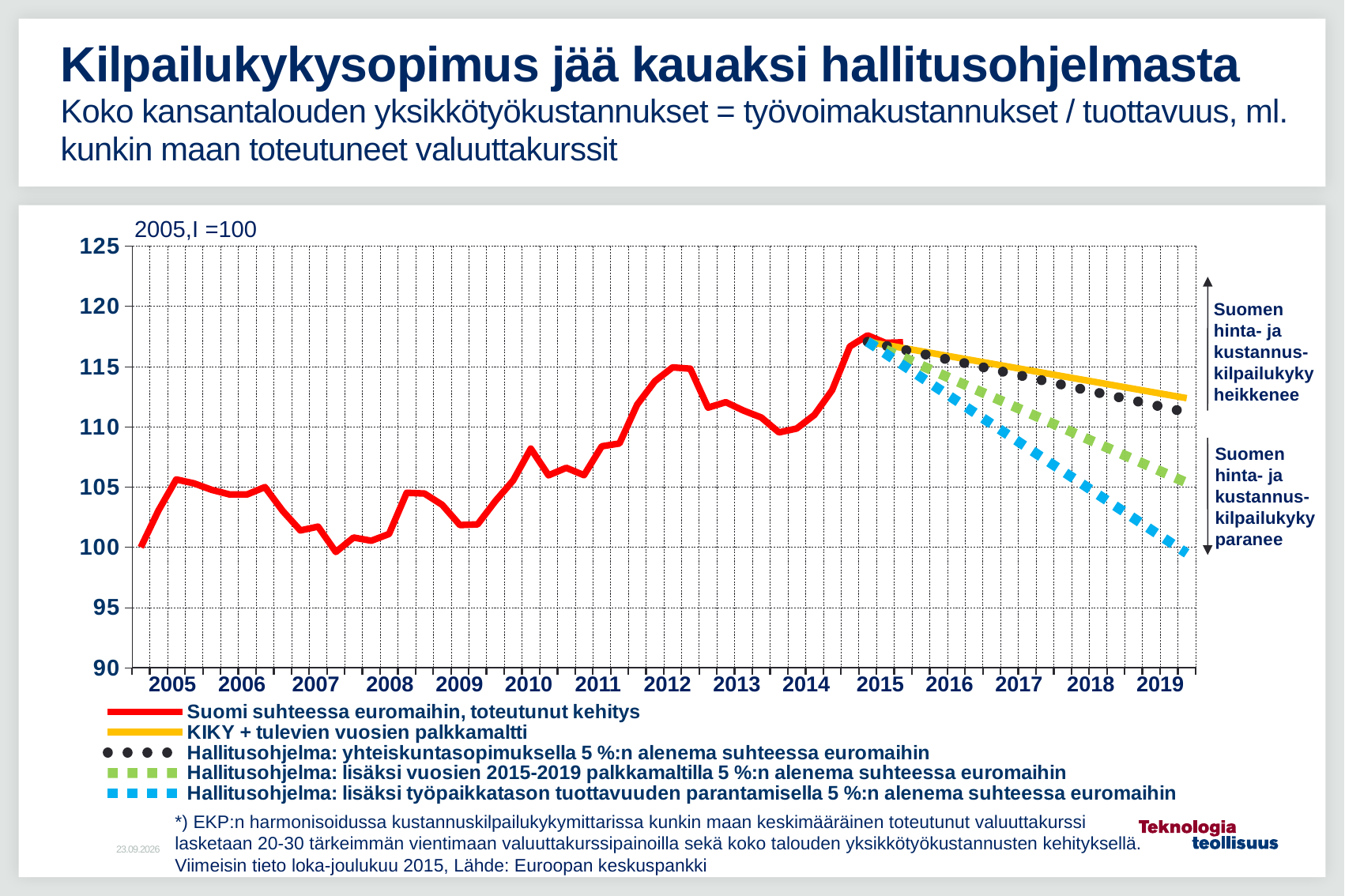
Is the value of the blue dotted line at the end of 2019 greater or less than 105? less Is the value of the red line (Suomi suhteessa euromaihin, toteutunut kehitys) in 2012 greater or less than 110? greater How many years are labelled on the x axis? 15 What is the base-year note printed above the y axis? 2005,I =100 Does the blue dotted line rise or fall from 2015 to 2019? fall At the end of 2019, which is higher: the yellow line (KIKY + tulevien vuosien palkkamaltti) or the blue dotted line? the yellow line Is the value of the red line in 2007 greater or less than 105? less How many series does the legend list? 5 What is the index value of the red line at the start of 2005, according to the base-year note on the chart? 100 Which series ends lowest in 2019? Hallitusohjelma: lisäksi työpaikkatason tuottavuuden parantamisella 5 %:n alenema suhteessa euromaihin (blue dotted line) What kind of chart is shown on the slide? line chart